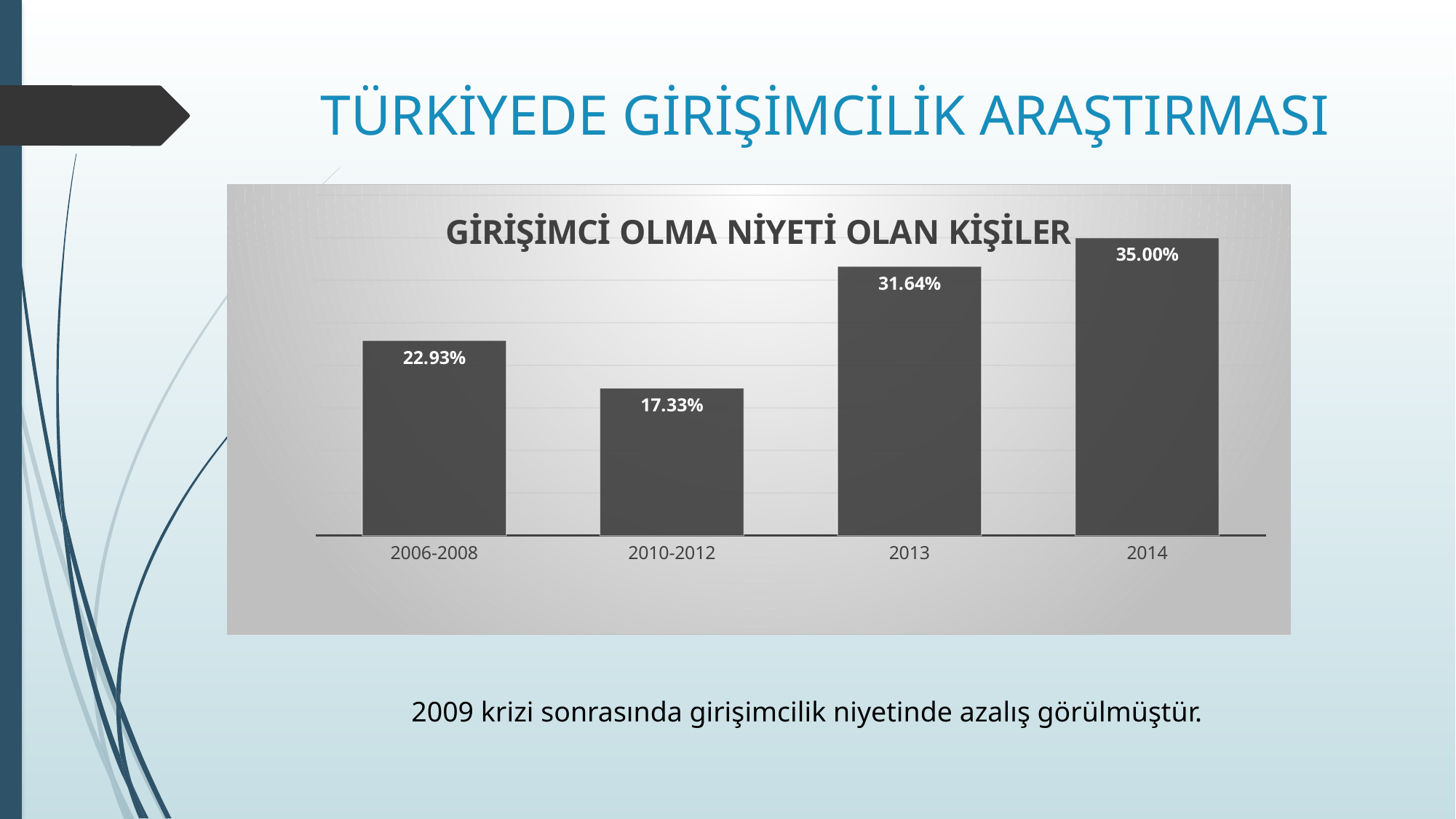
What is the value for 2014? 35.00% What is the value for 2006-2008? 22.93% Which category has the highest value? 2014 How many categories are shown on the x axis? 4 What is the title of the chart? GİRİŞİMCİ OLMA NİYETİ OLAN KİŞİLER What is the value for 2013? 31.64% What is the value for 2010-2012? 17.33% What kind of chart is shown on the slide? Bar chart Which is larger, the value for 2006-2008 or the value for 2013? 2013 Which category has the lowest value? 2010-2012 What is the difference between the values for 2006-2008 and 2010-2012? 5.60% What is the difference between the values for 2014 and 2013? 3.36%